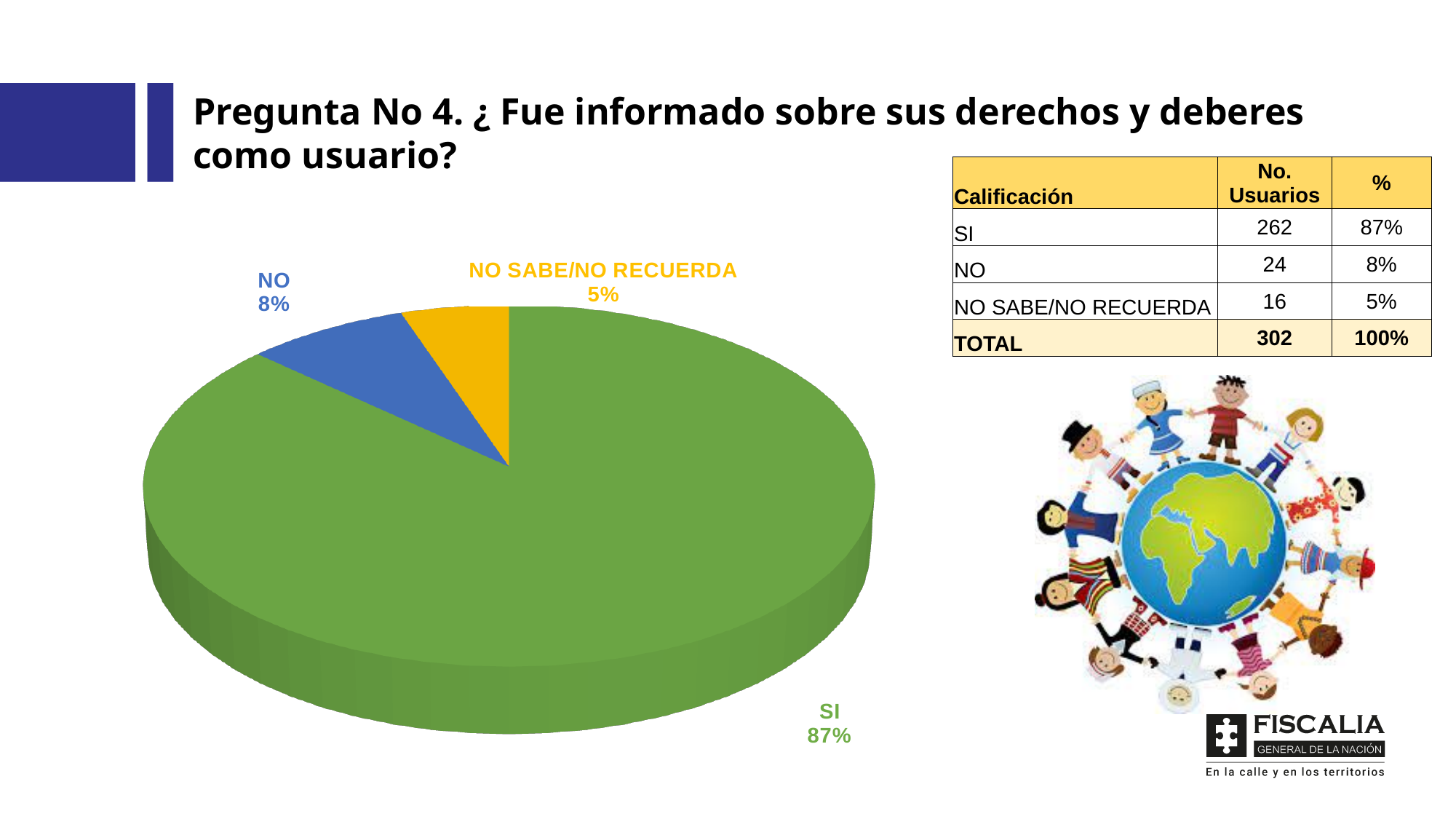
What percentage does the NO SABE/NO RECUERDA slice represent in the pie chart? 5% What percentage does the NO slice represent in the pie chart? 8% Which slice is larger in the pie chart, NO or NO SABE/NO RECUERDA? NO What percentage does the SI slice represent in the pie chart? 87% Which category has the largest slice in the pie chart? SI What kind of chart is shown on the slide? Pie chart What colour is the SI slice in the pie chart? Green What colour is the NO SABE/NO RECUERDA slice in the pie chart? Yellow What is the difference in percentage points between the SI slice and the NO slice? 79 Which category has the smallest slice in the pie chart? NO SABE/NO RECUERDA How many slices does the pie chart have? 3 What is the difference in percentage points between the NO slice and the NO SABE/NO RECUERDA slice? 3